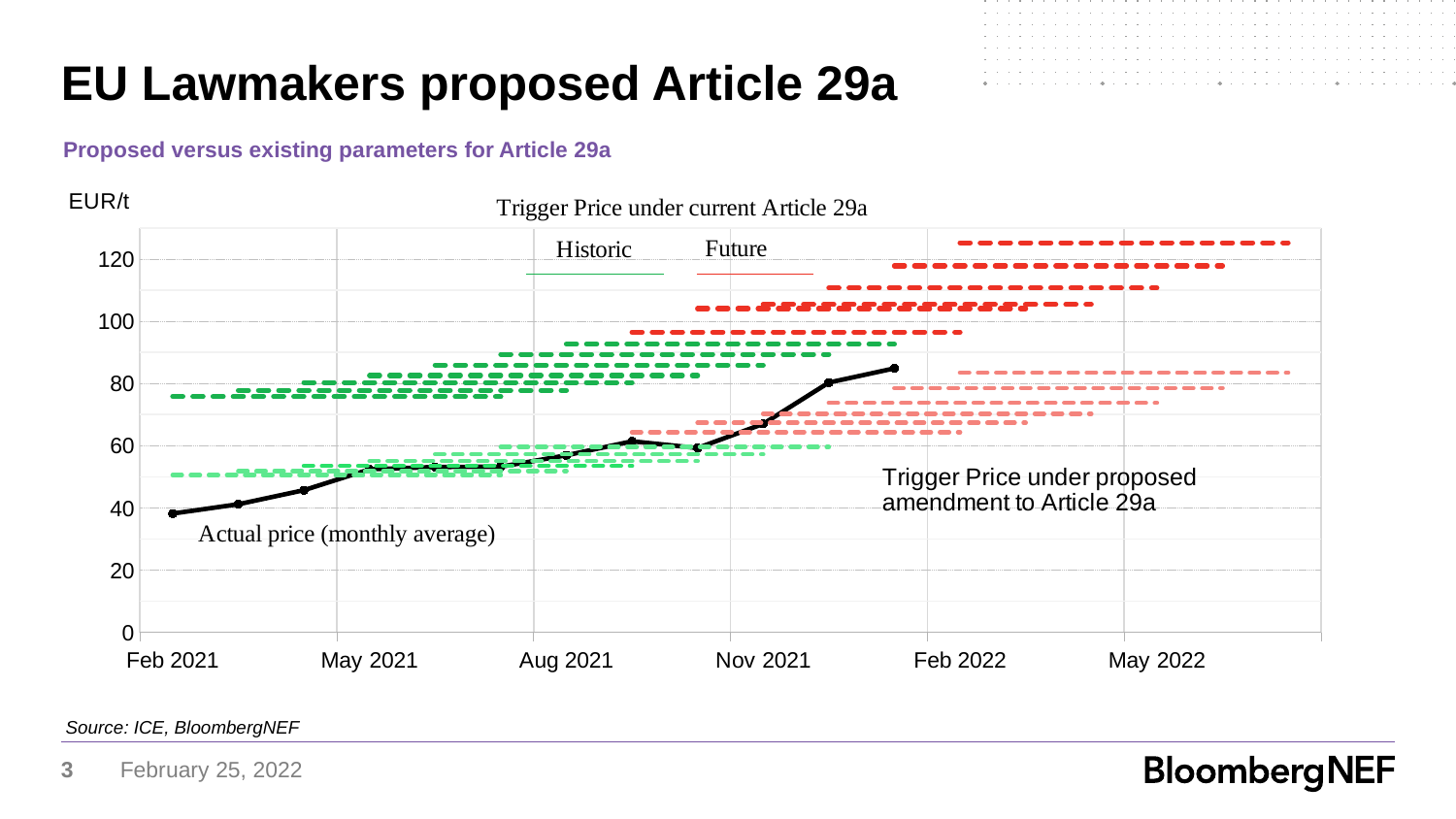
What is the title of the chart? Proposed versus existing parameters for Article 29a What is the highest tick value shown on the y axis? 120 Which is larger in Feb 2021: the actual price (monthly average) or the historic trigger price under current Article 29a? Historic trigger price under current Article 29a Is the actual price (monthly average) in May 2021 greater or less than 40? greater Is the actual price (monthly average) in Feb 2021 greater or less than 60? less Does the actual price (monthly average) rise or fall from Feb 2021 to the end of the series? Rise Is the actual price (monthly average) in Nov 2021 greater or less than 60? greater What unit is shown on the y axis of the chart? EUR/t What kind of chart is shown on the slide? Line chart How many date labels are shown on the x axis? 6